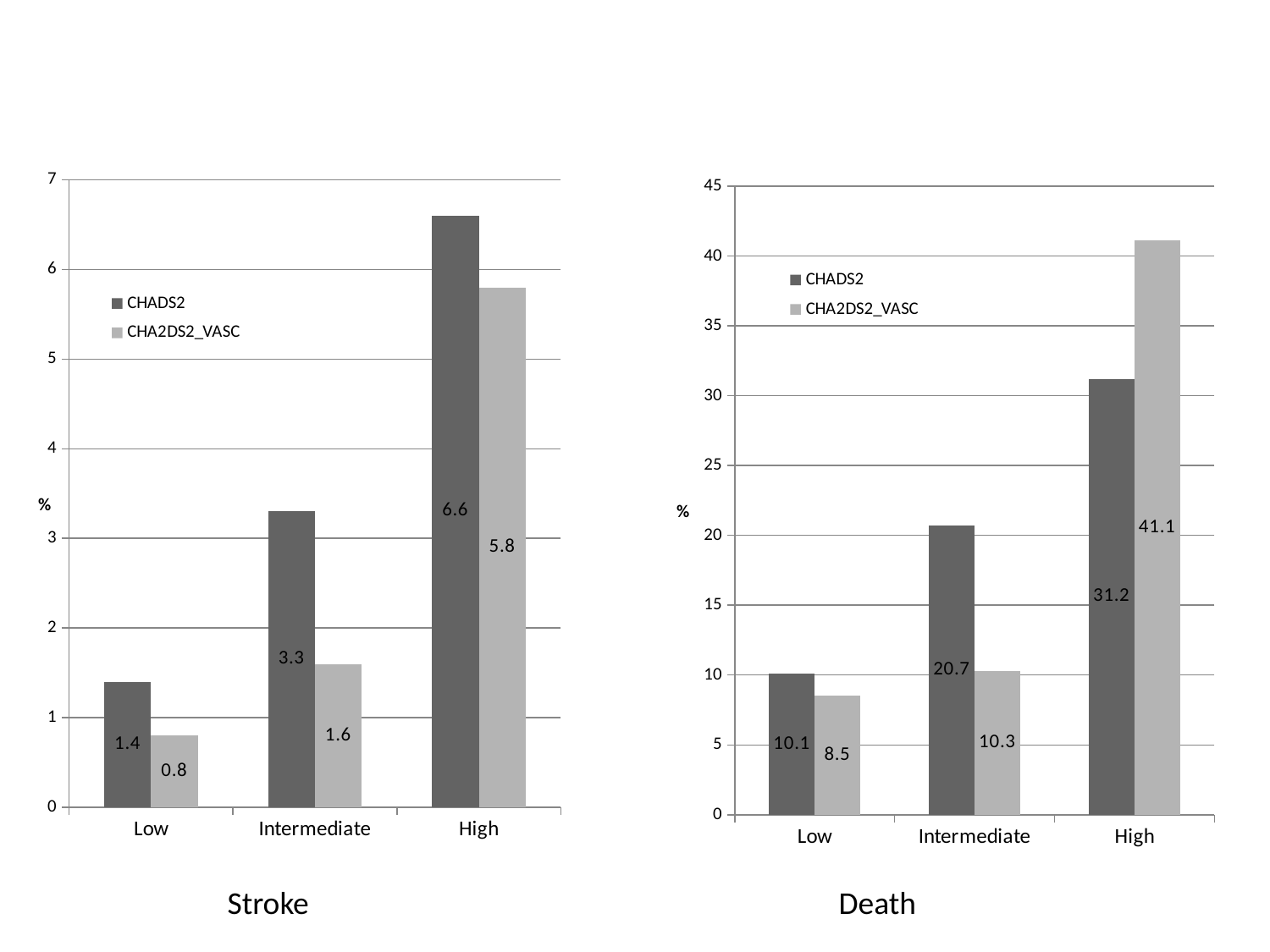
In the Death chart, which is larger for the Low category, CHADS2 or CHA2DS2_VASC? CHADS2 In the Death chart, which category has the highest CHADS2 value? High In the Stroke chart, which category has the lowest CHA2DS2_VASC value? Low In the Stroke chart, what is the CHADS2 value for the High category? 6.6 How many categories are shown on the x axis of the Stroke chart? 3 In the Death chart, what is the difference between the CHA2DS2_VASC and CHADS2 values for the High category? 9.9 What kind of chart is the Death chart? Bar chart In the Death chart, what is the CHA2DS2_VASC value for the High category? 41.1 In the Stroke chart, what is the CHA2DS2_VASC value for the Low category? 0.8 How many series does the legend of the Death chart list? 2 In the Death chart, what is the CHADS2 value for the Intermediate category? 20.7 In the Stroke chart, what is the difference between the CHADS2 and CHA2DS2_VASC values for the High category? 0.8